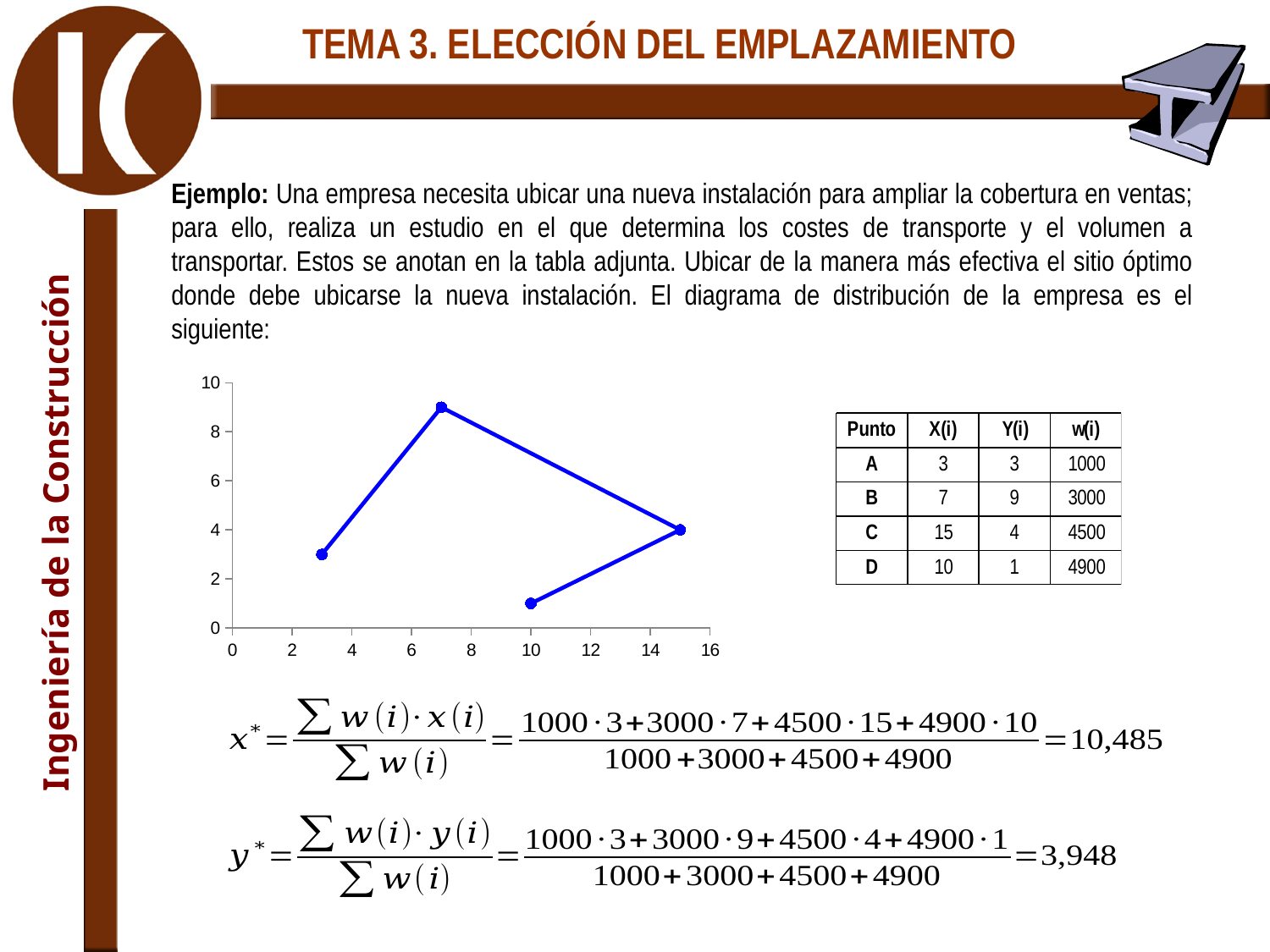
What colour is the line on the chart? blue What is the maximum value shown on the x axis of the chart? 16 Using the table values, what is the difference between the highest Y(i) and the lowest Y(i) plotted on the chart? 8 Which has the larger x value on the chart: the highest point or the lowest point? the lowest point What is the x value of the lowest point on the chart? 10 Is the y value of the rightmost point on the chart greater or less than 6? less According to the table, which point (A, B, C or D) has the lowest Y(i) value on the chart? D What is the y value of the rightmost point on the chart? 4 Is the x value of the highest point on the chart greater or less than 8? less What kind of chart is shown on the slide? line chart According to the table, which point (A, B, C or D) has the highest Y(i) value on the chart? B How many data points are plotted on the chart? 4